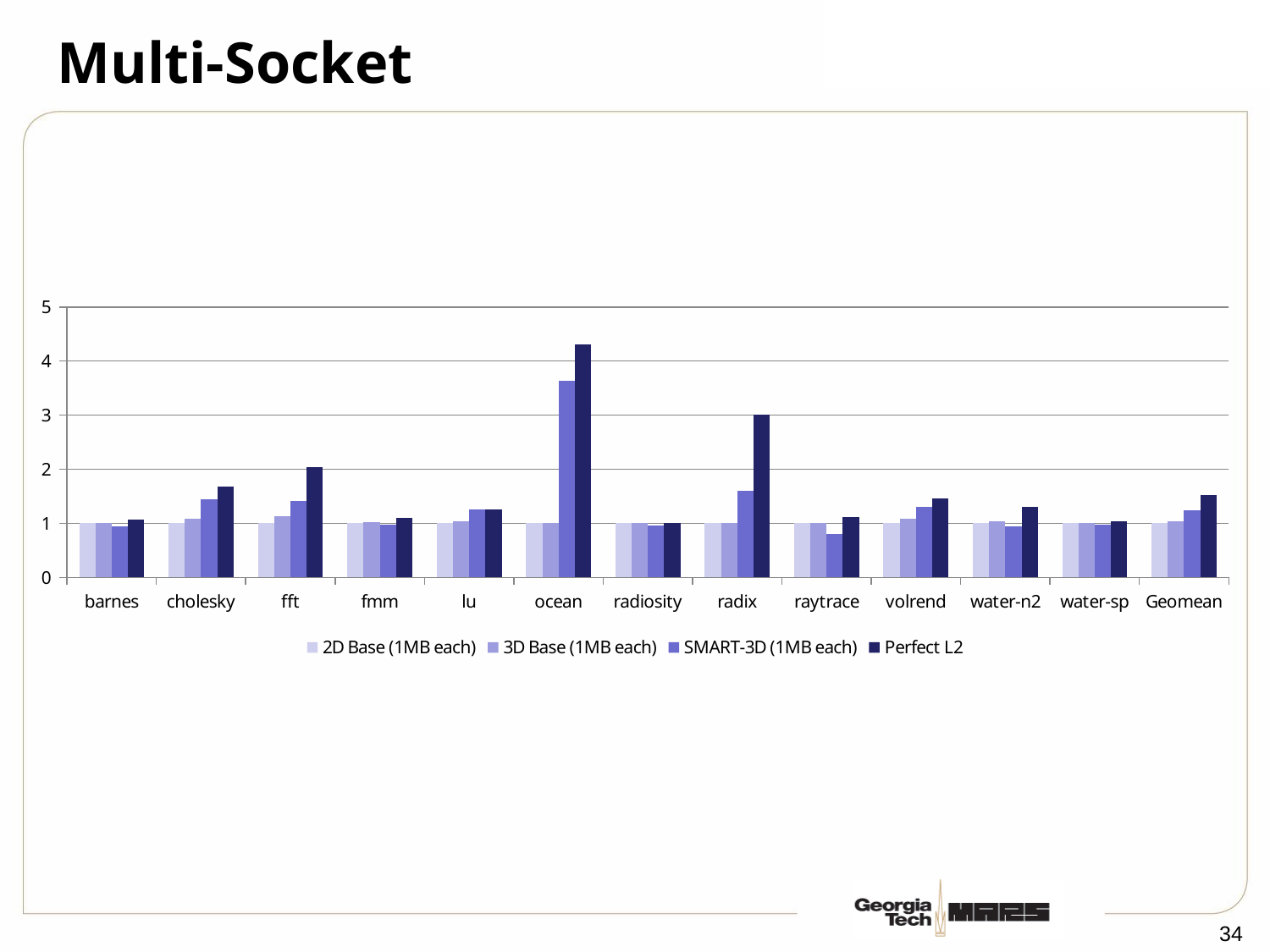
Is the Perfect L2 value for Geomean greater or less than 2? less How many categories are shown along the x axis? 13 Which category has the highest Perfect L2 value? ocean Is the SMART-3D (1MB each) value for raytrace greater or less than 1? less How many series does the legend list? 4 What is the last series listed in the legend? Perfect L2 Is the Perfect L2 value for ocean greater or less than 4? greater What kind of chart is shown on the slide? bar chart Which is larger for radix: the SMART-3D (1MB each) value or the Perfect L2 value? Perfect L2 Which is larger for cholesky: the 3D Base (1MB each) value or the SMART-3D (1MB each) value? SMART-3D (1MB each)